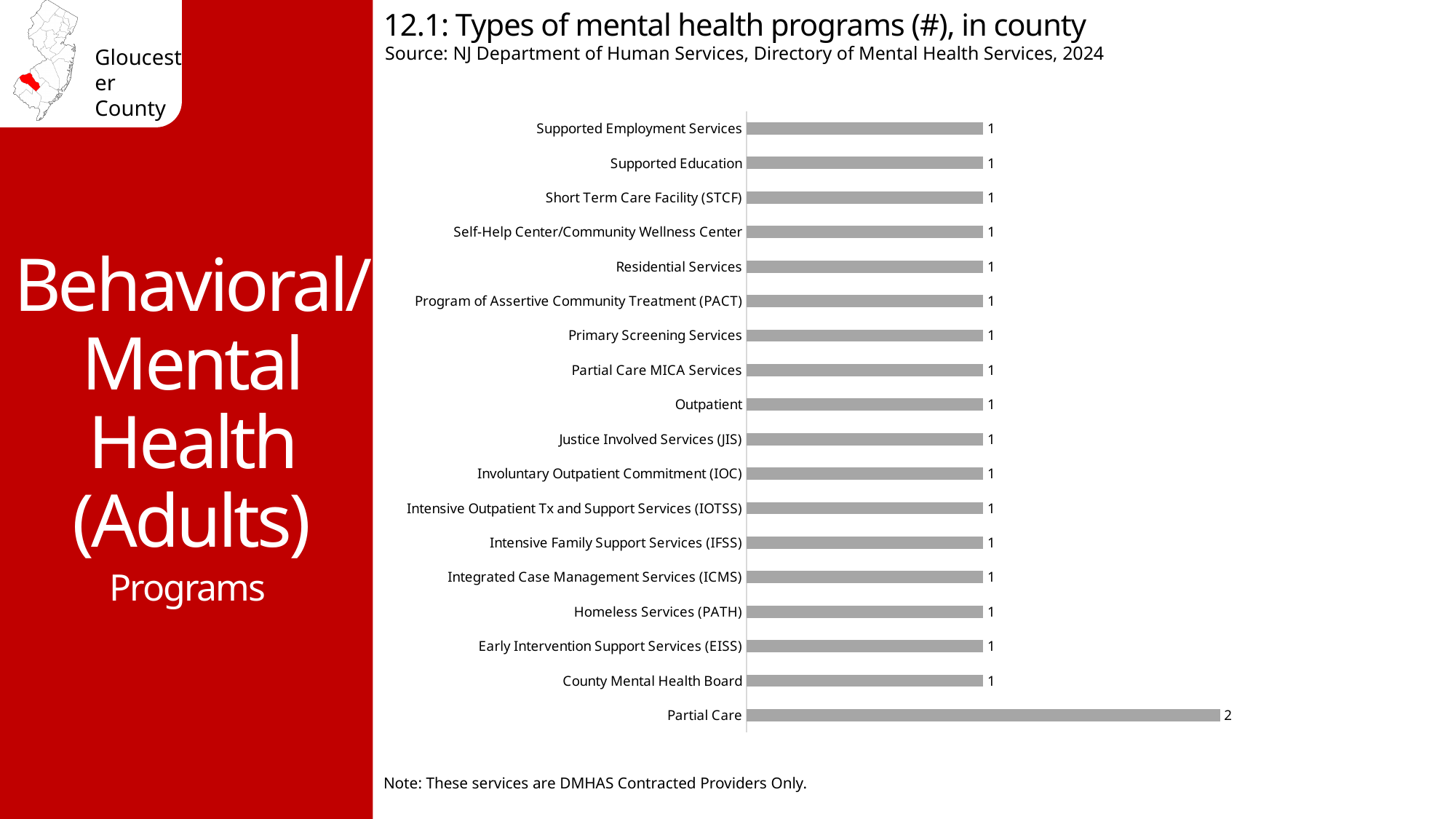
What kind of chart is shown on the slide? Bar chart Which program type has the highest value? Partial Care What is the value for Program of Assertive Community Treatment (PACT)? 1 What is the source cited for the chart? NJ Department of Human Services, Directory of Mental Health Services, 2024 What is the value for Outpatient? 1 What is the difference between the values for Partial Care and Partial Care MICA Services? 1 What is the title of the chart? 12.1: Types of mental health programs (#), in county Which is larger, the value for Partial Care or the value for Residential Services? Partial Care What is the value for County Mental Health Board? 1 How many program types are shown in the chart? 18 What is the value for Partial Care? 2 What is the value for Homeless Services (PATH)? 1